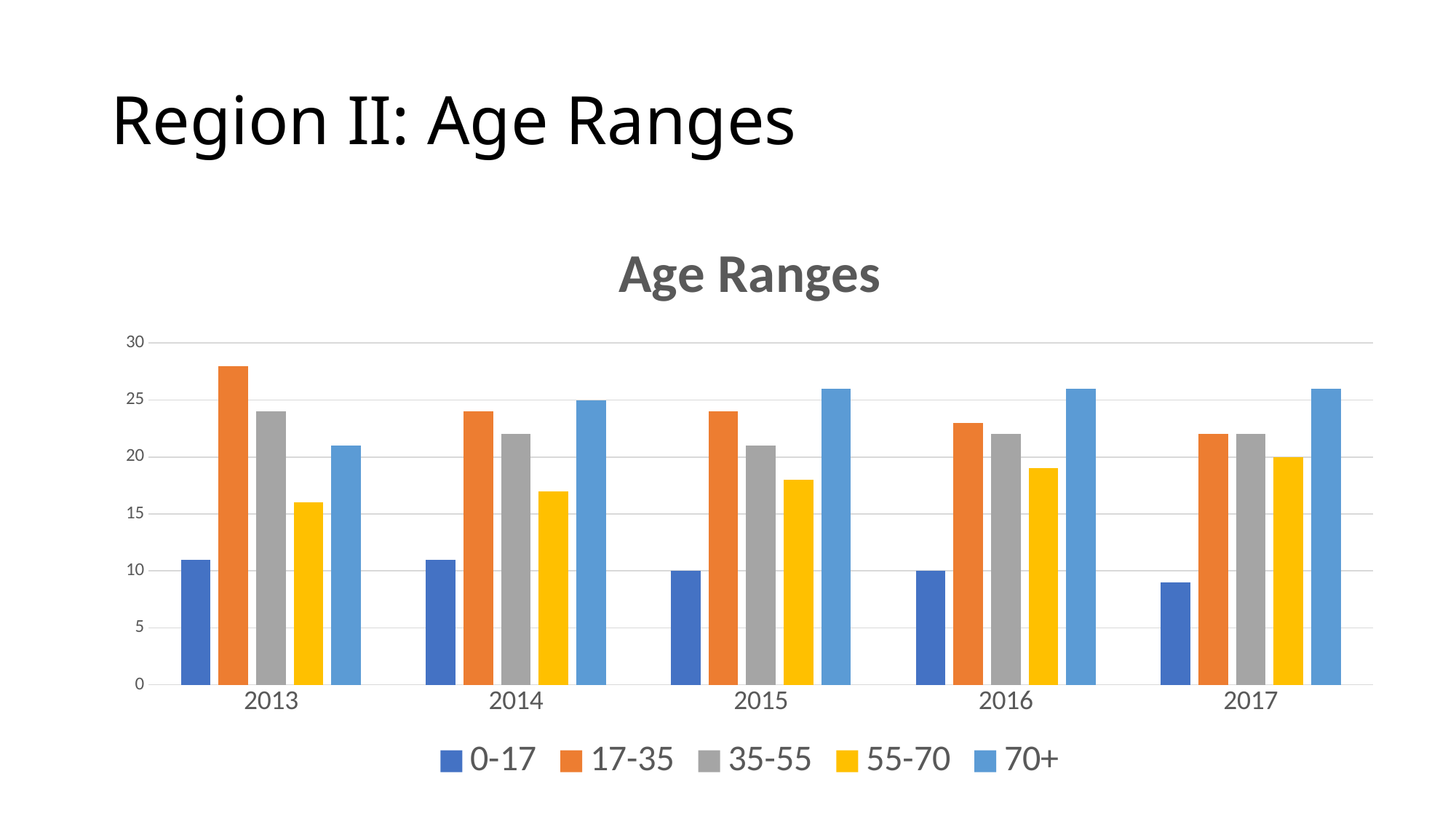
Which age range has the highest bar in 2017? 70+ Is the value for 17-35 in 2013 greater or less than 25? greater How many years are shown on the x axis? 5 Which age range has the lowest bar in 2015? 0-17 Do the values for the 0-17 series rise or fall from 2013 to 2017? fall How many series does the legend list? 5 Is the value for 0-17 in 2017 greater or less than 10? less What kind of chart is shown on the slide? bar chart In 2013, which is larger: the value for 17-35 or the value for 70+? 17-35 Is the value for 55-70 in 2014 greater or less than 20? less Which age range has the highest bar in 2013? 17-35 What is the title of the chart? Age Ranges